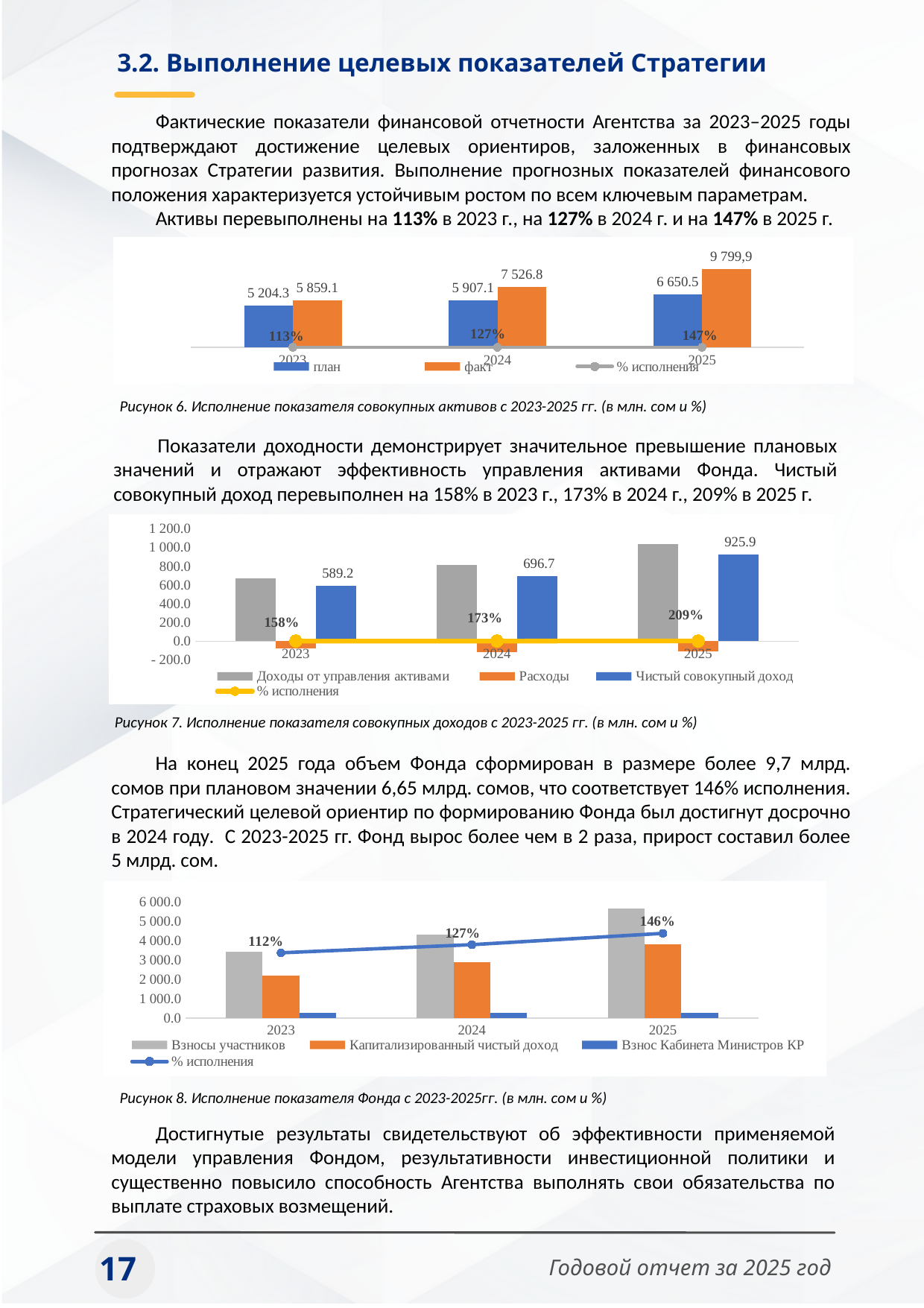
In the top chart (Рисунок 6), what is the difference between факт and план in 2024? 1 619.7 In the middle chart (Рисунок 7), what is the Чистый совокупный доход value for 2024? 696.7 In the bottom chart (Рисунок 8), is the Взносы участников value for 2025 greater or less than 5 000.0? greater In the bottom chart (Рисунок 8), what is the % исполнения for 2023? 112% In the middle chart (Рисунок 7), does the Чистый совокупный доход rise or fall from 2023 to 2025? rise In the top chart (Рисунок 6), what is the факт value for 2025? 9 799,9 In the middle chart (Рисунок 7), how many series does the legend list? 4 In the middle chart (Рисунок 7), what is the % исполнения for 2025? 209% In the bottom chart (Рисунок 8), which series is shown in grey? Взносы участников In the top chart (Рисунок 6), what is the план value for 2023? 5 204.3 In the top chart (Рисунок 6), which year has the highest факт value? 2025 In the top chart (Рисунок 6), how many series does the legend list? 3